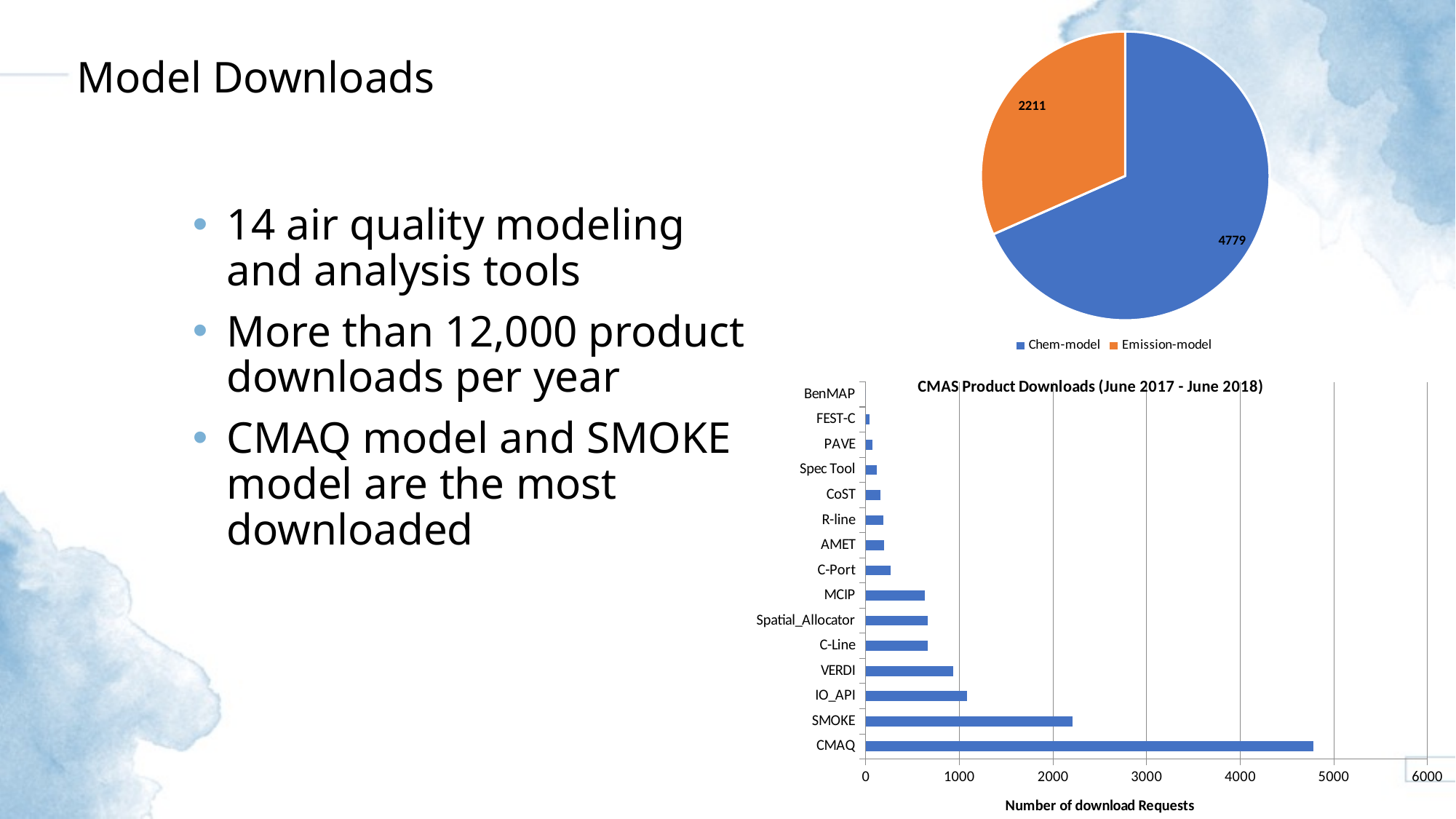
In the chart titled 'CMAS Product Downloads (June 2017 - June 2018)', how many products are listed on the vertical axis? 15 In the pie chart, what is the value for Chem-model? 4779 In the chart titled 'CMAS Product Downloads (June 2017 - June 2018)', is the value for SMOKE greater or less than 2000? greater In the pie chart, how many series does the legend list? 2 In the pie chart, which slice is larger, Chem-model or Emission-model? Chem-model In the chart titled 'CMAS Product Downloads (June 2017 - June 2018)', which product has the highest number of download requests? CMAQ What kind of chart is the one titled 'CMAS Product Downloads (June 2017 - June 2018)'? Bar chart In the pie chart, what is the value for Emission-model? 2211 In the chart titled 'CMAS Product Downloads (June 2017 - June 2018)', is the value for CMAQ greater or less than 4000? greater In the pie chart, what is the difference between the Chem-model and Emission-model values? 2568 In the chart titled 'CMAS Product Downloads (June 2017 - June 2018)', which product has the lowest number of download requests? BenMAP